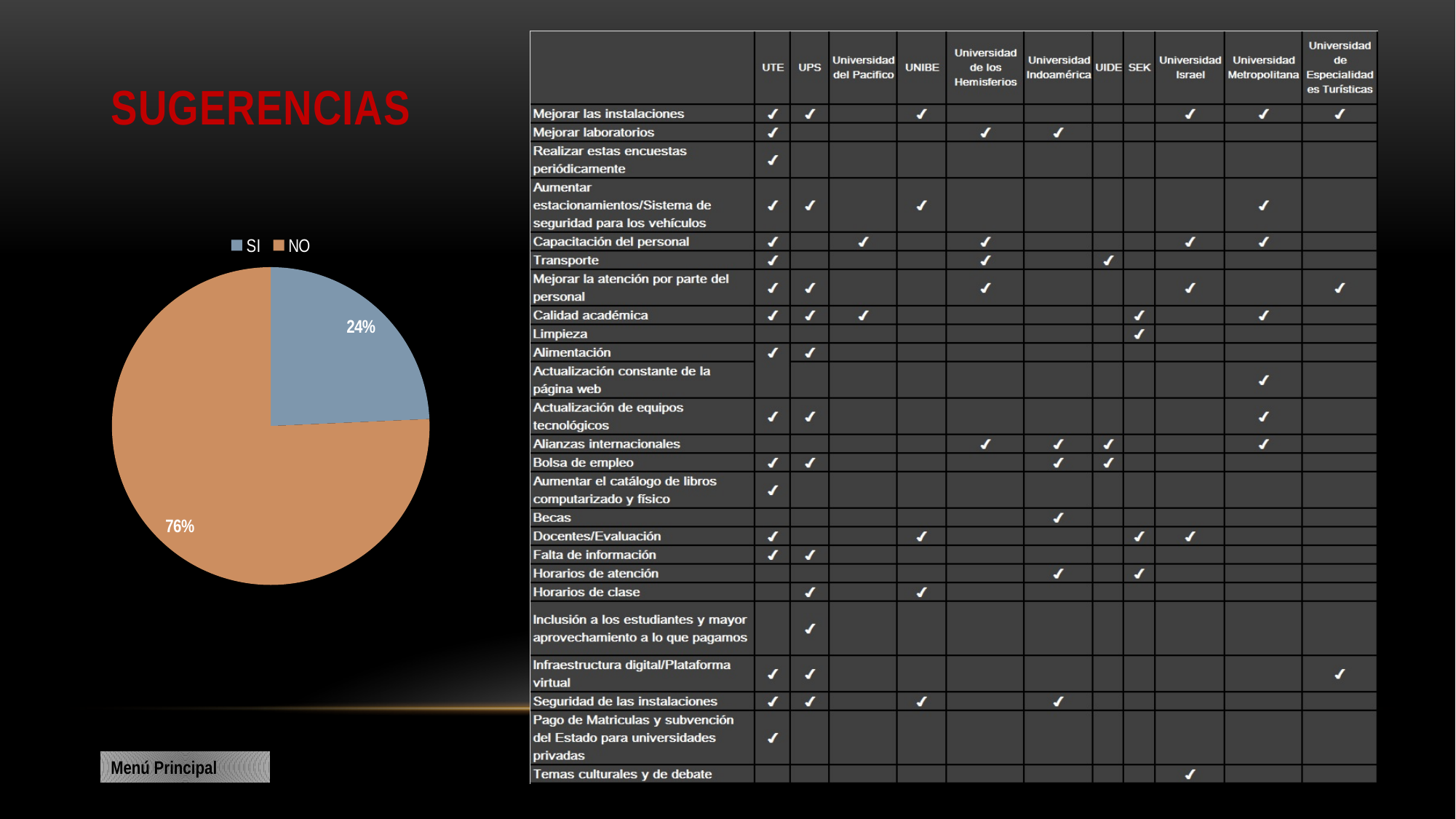
What colour is the NO slice of the pie chart? orange/brown How many entries does the pie chart legend list? 2 Which slice of the pie chart is the largest? NO What is the difference in percentage points between the NO slice and the SI slice? 52 What colour is the SI slice of the pie chart? blue Which slice of the pie chart is the smallest? SI What percentage does the SI slice of the pie chart show? 24% How many slices does the pie chart have? 2 Which is larger in the pie chart, SI or NO? NO What share of the pie does the SI slice represent? 24% What kind of chart is shown on the slide? pie chart What percentage does the NO slice of the pie chart show? 76%